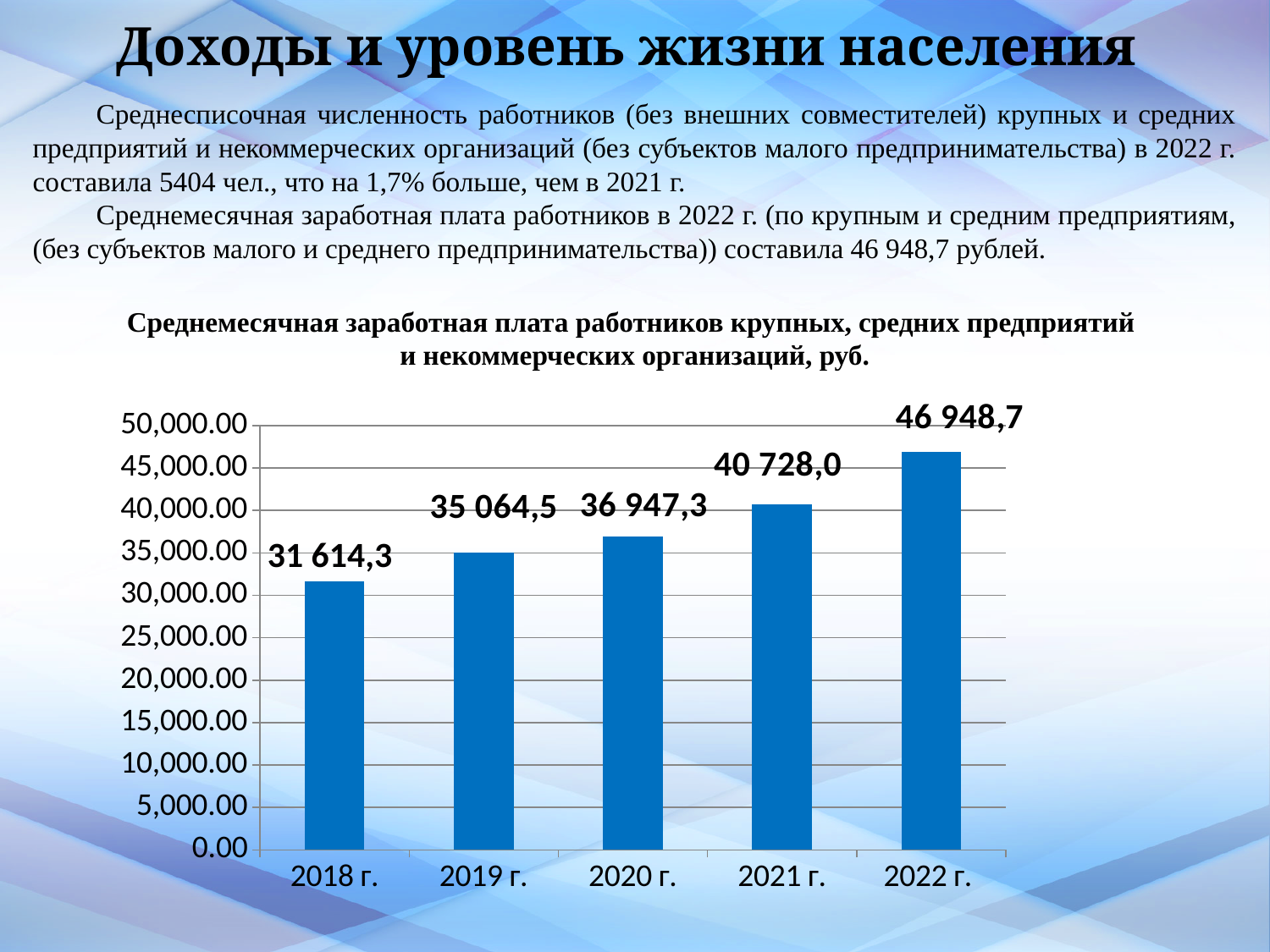
How many years are shown on the chart? 5 What is the difference between the values for 2019 г. and 2018 г.? 3 450,2 What is the difference between the values for 2022 г. and 2021 г.? 6 220,7 Which year has the lowest value? 2018 г. What is the value for 2021 г.? 40 728,0 Which year has the highest value? 2022 г. Do the values rise or fall from 2018 г. to 2022 г.? rise What kind of chart is shown on the slide? bar chart What is the value for 2020 г.? 36 947,3 What is the value for 2018 г.? 31 614,3 Which is larger, the value for 2019 г. or the value for 2020 г.? 2020 г. Is the value for 2021 г. greater or less than 40,000.00? greater